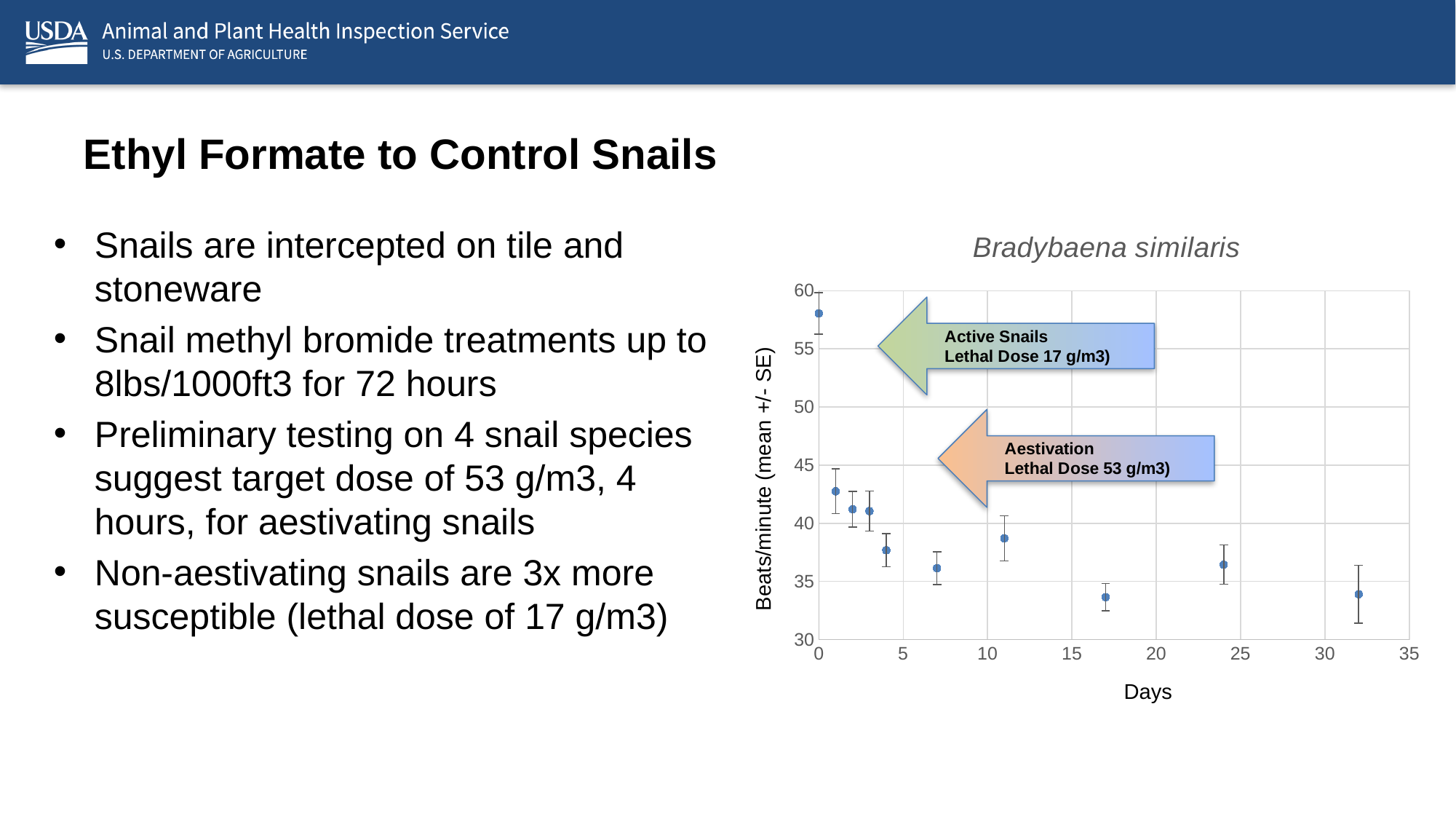
Is the beats/minute value at day 1 greater or less than 40? greater Is the beats/minute value at day 17 greater or less than 35? less How many data points are plotted on the chart? 10 At which day is the beats/minute value highest? Day 0 What is the title of the chart? Bradybaena similaris Is the beats/minute value at day 0 greater or less than 55? greater Overall, do the beats/minute values rise or fall as the days increase? Fall Which has a higher beats/minute value, day 0 or day 1? Day 0 What is the label of the y axis of the chart? Beats/minute (mean +/- SE) What kind of chart is shown on the slide? Scatter plot Which has a higher beats/minute value, day 11 or day 17? Day 11